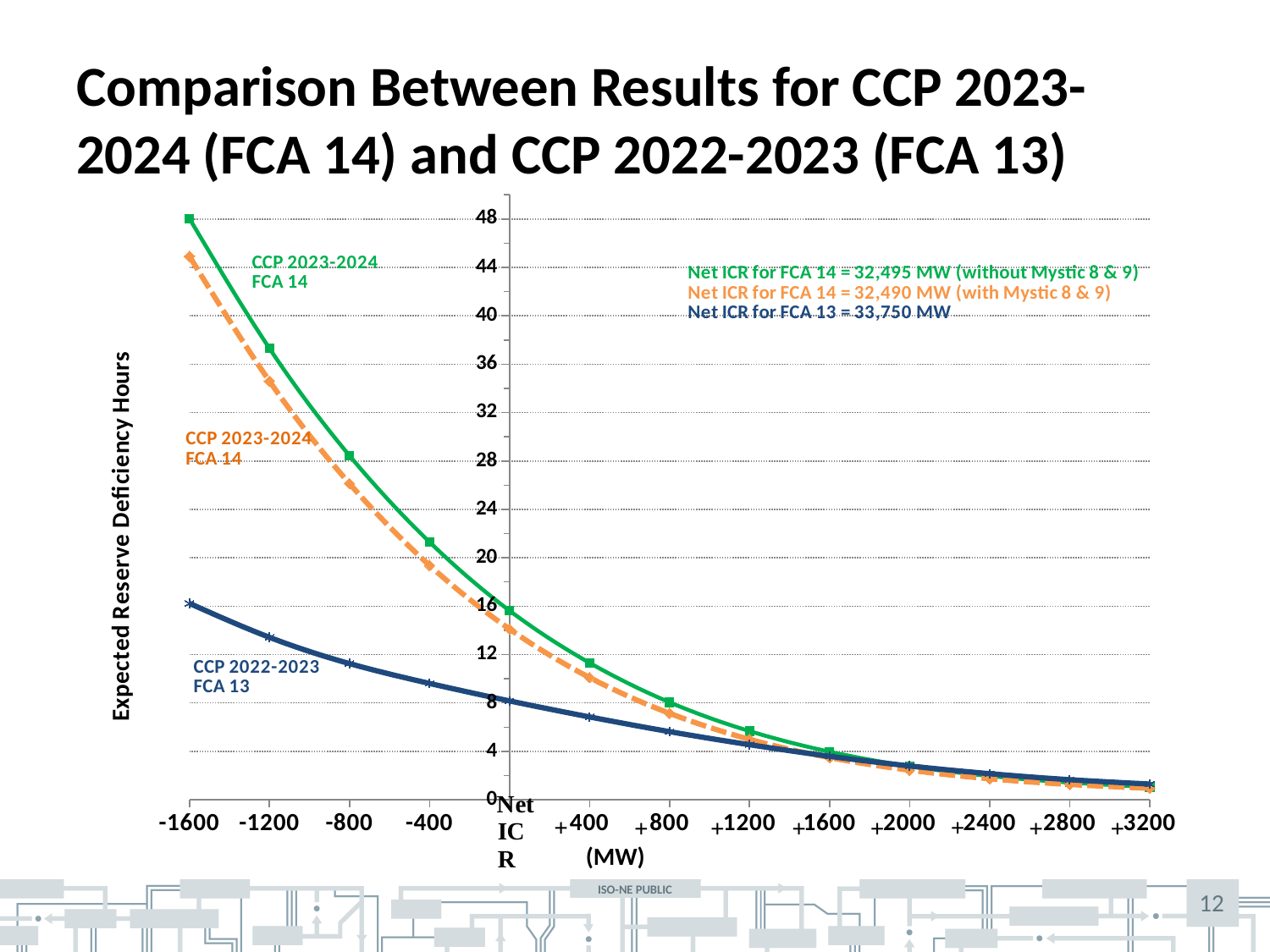
Is the value of the green CCP 2023-2024 FCA 14 line at -1600 MW greater or less than 40? greater According to the annotation on the chart, what is the Net ICR for FCA 13? 33,750 MW At -800 MW, which line is higher: the green CCP 2023-2024 FCA 14 line or the CCP 2022-2023 FCA 13 line? the green CCP 2023-2024 FCA 14 line Is the value of the CCP 2022-2023 FCA 13 line at +400 MW greater or less than 8? less What is the y-axis label of the chart? Expected Reserve Deficiency Hours What kind of chart is shown on the slide? line chart Do the expected reserve deficiency hours rise or fall as the MW value on the x axis increases? fall Is the value of the orange dashed CCP 2023-2024 FCA 14 line at -1200 MW greater or less than 32? greater Which series has the lowest value at -1600 MW? CCP 2022-2023 FCA 13 How many data series are plotted on the chart? 3 Which series has the highest value at -1600 MW? the green CCP 2023-2024 FCA 14 line